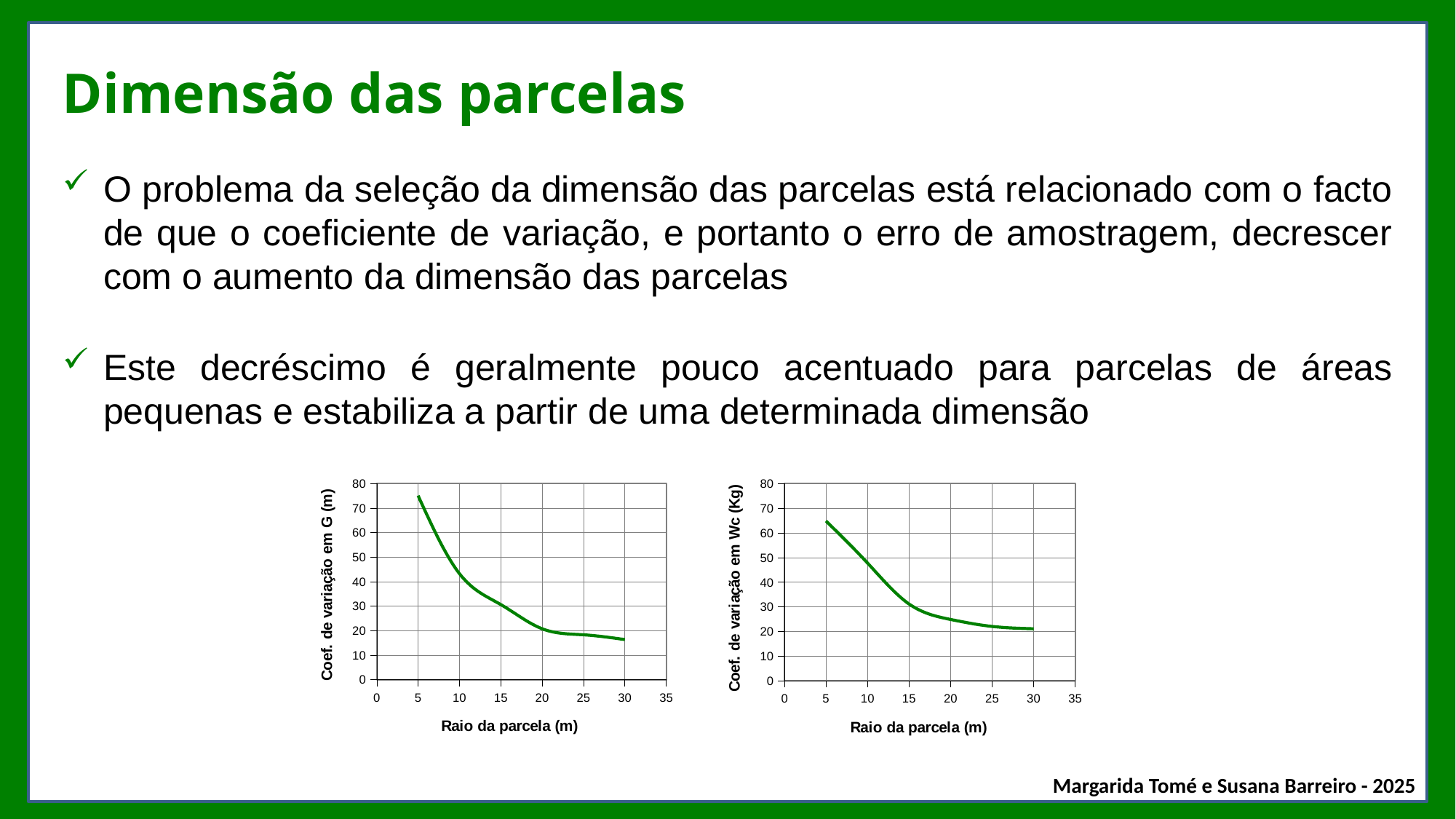
In the left chart (Coef. de variação em G), is the value at a plot radius of 30 m greater or less than 20? less At a plot radius of 5 m, which chart shows the higher coefficient of variation: the left chart (G) or the right chart (Wc)? the left chart (G) In the left chart (Coef. de variação em G), is the value at a plot radius of 10 m greater or less than 30? greater In the left chart (Coef. de variação em G), is the value at a plot radius of 15 m greater or less than 40? less What is the x-axis label of the right chart? Raio da parcela (m) In the left chart (Coef. de variação em G), do the values rise or fall as the plot radius increases? fall In the right chart (Coef. de variação em Wc), do the values rise or fall as the plot radius increases? fall What kind of chart is the left chart on the slide? line chart